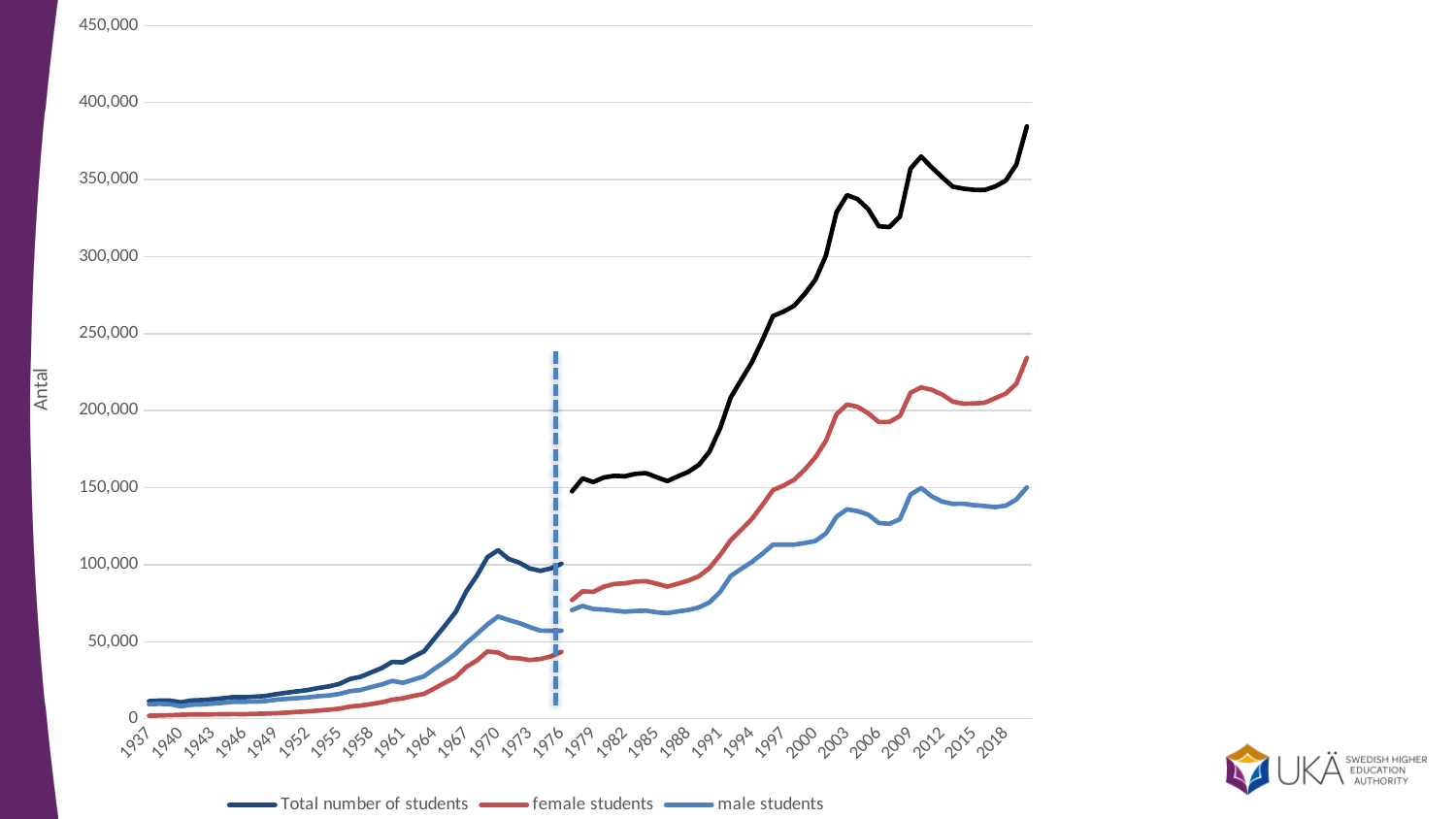
How many series does the legend list? 3 Is the value for Total number of students in 2003 greater or less than 300,000? greater Does the Total number of students generally rise or fall from 1937 to 2018? rise In 1937, which is larger: female students or male students? male students What type of chart is shown on the slide? line chart What is the label on the vertical axis? Antal Which series are listed in the legend? Total number of students, female students, male students Is the value for female students in 2018 greater or less than 200,000? greater Is the value for Total number of students in 1937 greater or less than 50,000? less In 2018, which is larger: female students or male students? female students